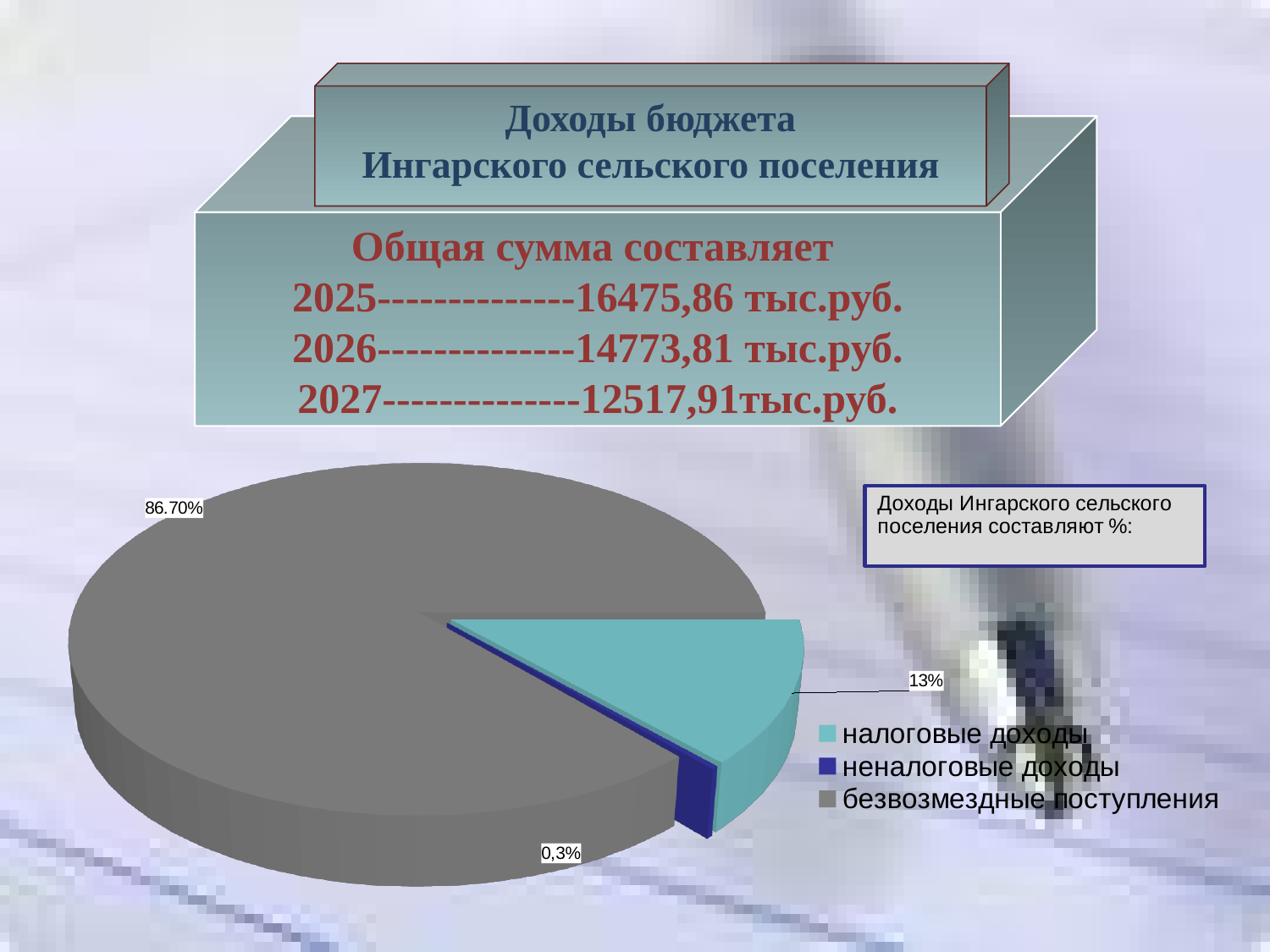
How many slices does the pie chart have? 3 What share of the pie is labelled for налоговые доходы? 13% What kind of chart is shown on the slide? pie chart Which category has the smallest slice of the pie? неналоговые доходы By how many percentage points does the share of безвозмездные поступления exceed the share of налоговые доходы? 73.70 percentage points Which is larger, the slice for налоговые доходы or the slice for неналоговые доходы? налоговые доходы Which category has the largest slice of the pie? безвозмездные поступления What text appears in the box next to the pie chart? Доходы Ингарского сельского поселения составляют %: What share of the pie is labelled for неналоговые доходы? 0,3% What share of the pie is labelled for безвозмездные поступления? 86.70% What colour is the slice for безвозмездные поступления? grey How many entries does the legend list? 3